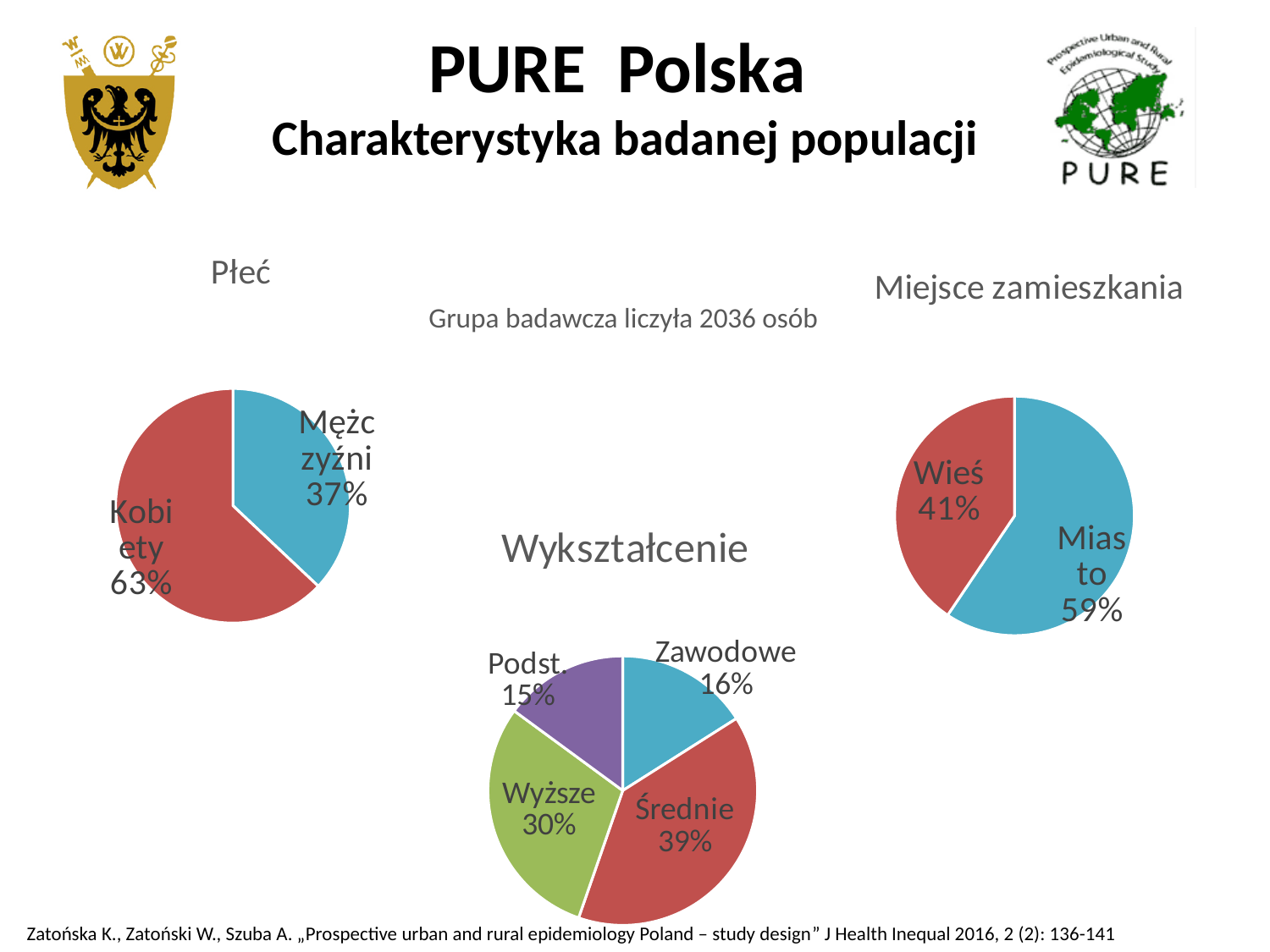
In the 'Miejsce zamieszkania' pie chart, what share is labelled for Wieś? 41% In the 'Wykształcenie' pie chart, what is the difference in percentage points between Wyższe and Zawodowe? 14 In the 'Wykształcenie' pie chart, which category has the smallest share? Podst. In the 'Wykształcenie' pie chart, what share is labelled for Średnie? 39% In the 'Płeć' pie chart, what share is labelled for Kobiety? 63% In the 'Miejsce zamieszkania' pie chart, which is larger, Miasto or Wieś? Miasto How many pie charts are shown on the slide? 3 In the 'Wykształcenie' pie chart, which category has the largest share? Średnie In the 'Wykształcenie' pie chart, how many categories are shown? 4 What type of chart is the 'Płeć' chart? Pie chart